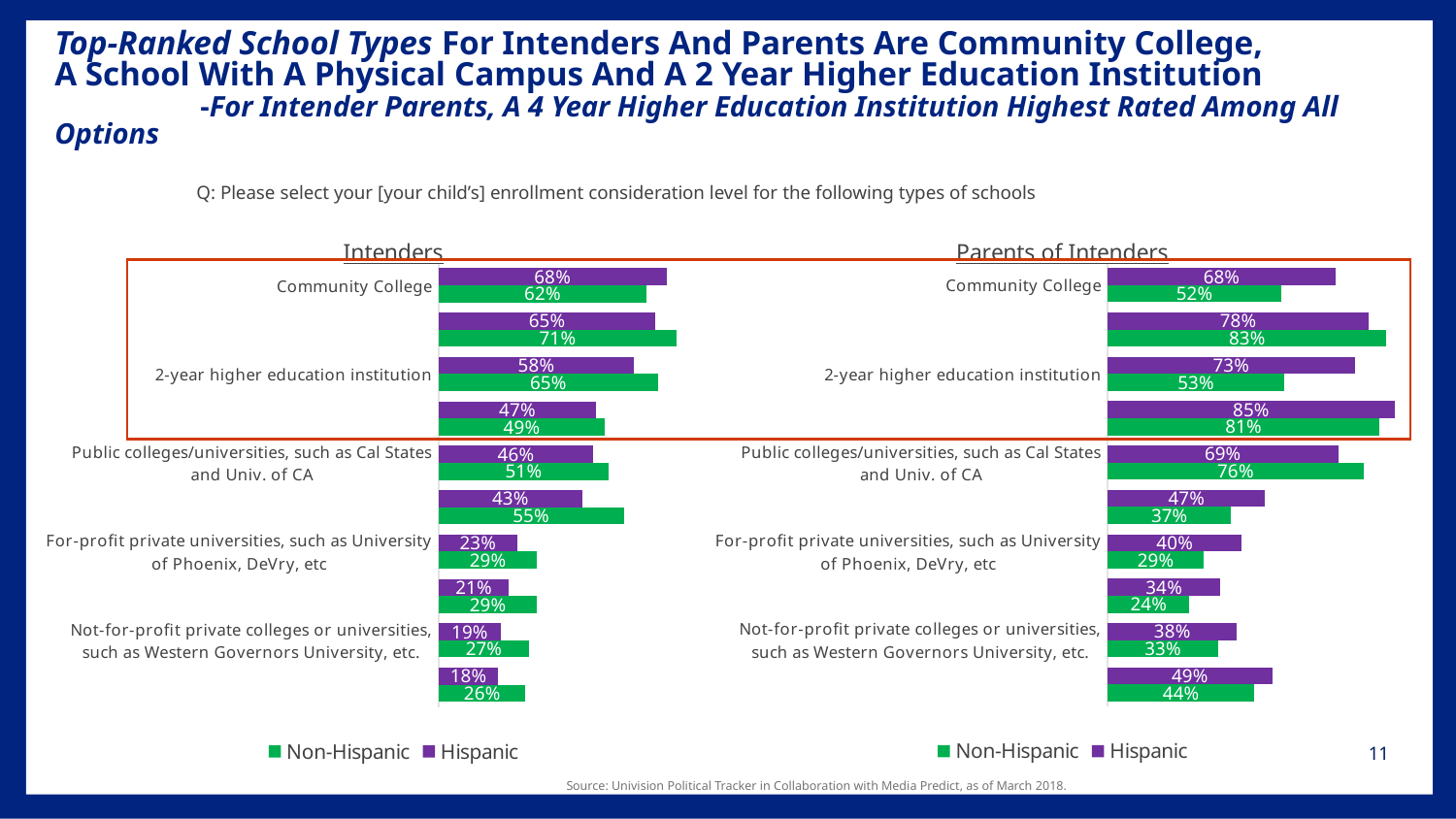
In the Intenders chart, what is the Non-Hispanic value for Public colleges/universities, such as Cal States and Univ. of CA? 51% In the Parents of Intenders chart, what is the Hispanic value for For-profit private universities, such as University of Phoenix, DeVry, etc? 40% How many series does the legend of the Intenders chart list? 2 In the Intenders chart, what is the Hispanic value for Community College? 68% In the Parents of Intenders chart, what is the Hispanic value for 2-year higher education institution? 73% In the Parents of Intenders chart, which is larger for Community College, the Hispanic value or the Non-Hispanic value? Hispanic In the Parents of Intenders chart, what is the Non-Hispanic value for Community College? 52% In the Intenders chart, what is the difference between the Hispanic and Non-Hispanic values for Community College? 6% What type of chart is the Parents of Intenders chart? Bar chart In the Intenders chart, what is the Non-Hispanic value for Community College? 62% In the Parents of Intenders chart, what is the difference between the Non-Hispanic and Hispanic values for Public colleges/universities, such as Cal States and Univ. of CA? 7% In the Intenders chart, which is larger for 2-year higher education institution, the Hispanic value or the Non-Hispanic value? Non-Hispanic